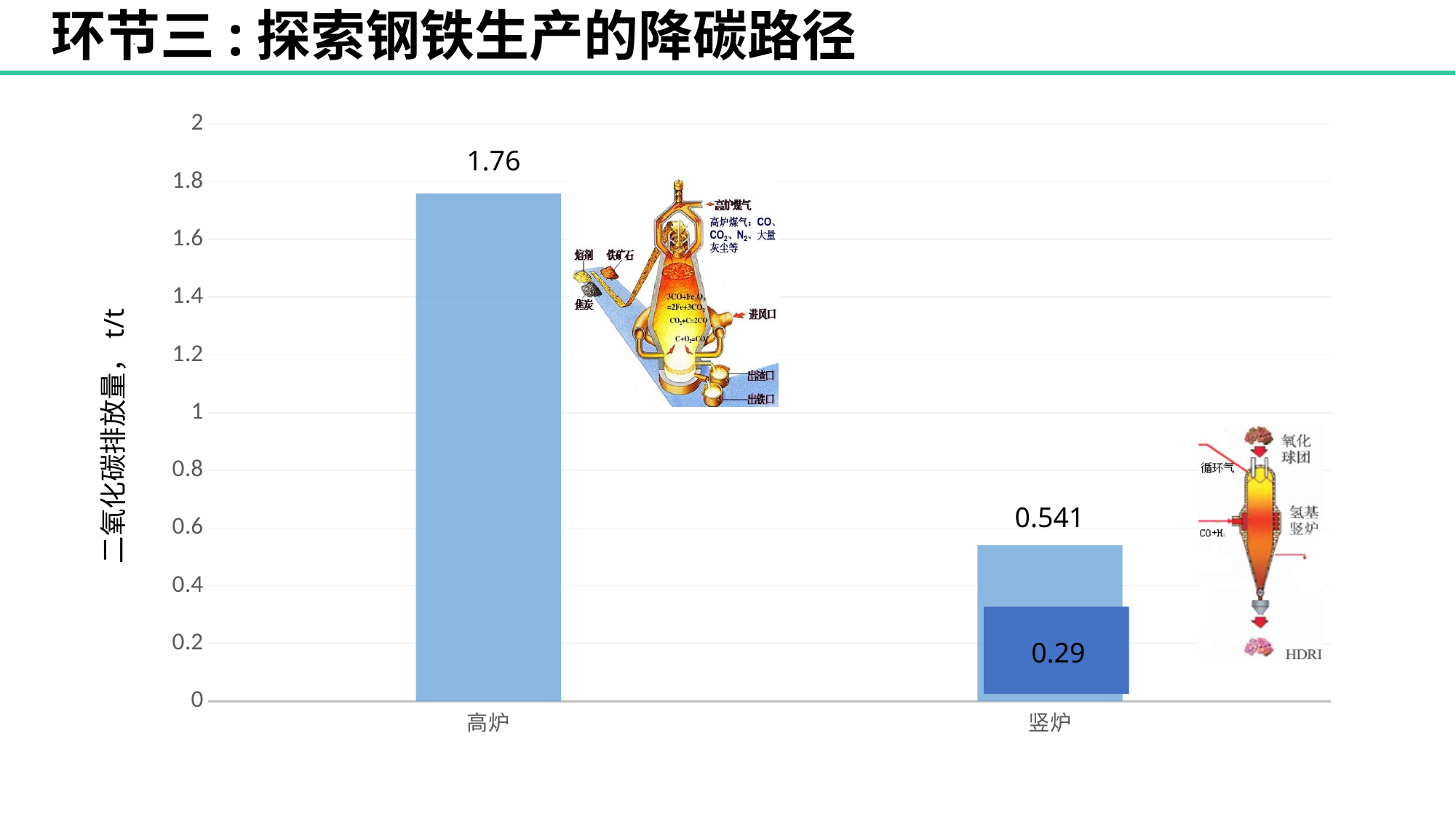
What is the value shown for 高炉? 1.76 Which category has the highest value? 高炉 What is the difference between the two values shown for 竖炉 (0.541 and 0.29)? 0.251 Is the value for 高炉 greater or less than 1.6? greater How many categories are shown on the x axis? 2 What is the value of the light blue bar for 竖炉? 0.541 What is the label of the y axis? 二氧化碳排放量，t/t Which category has the lowest value? 竖炉 What is the value of the dark blue bar for 竖炉? 0.29 What kind of chart is shown on the slide? bar chart Which is larger, the value for 高炉 or the value for 竖炉? 高炉 What is the difference between the value for 高炉 and the light blue value for 竖炉? 1.219